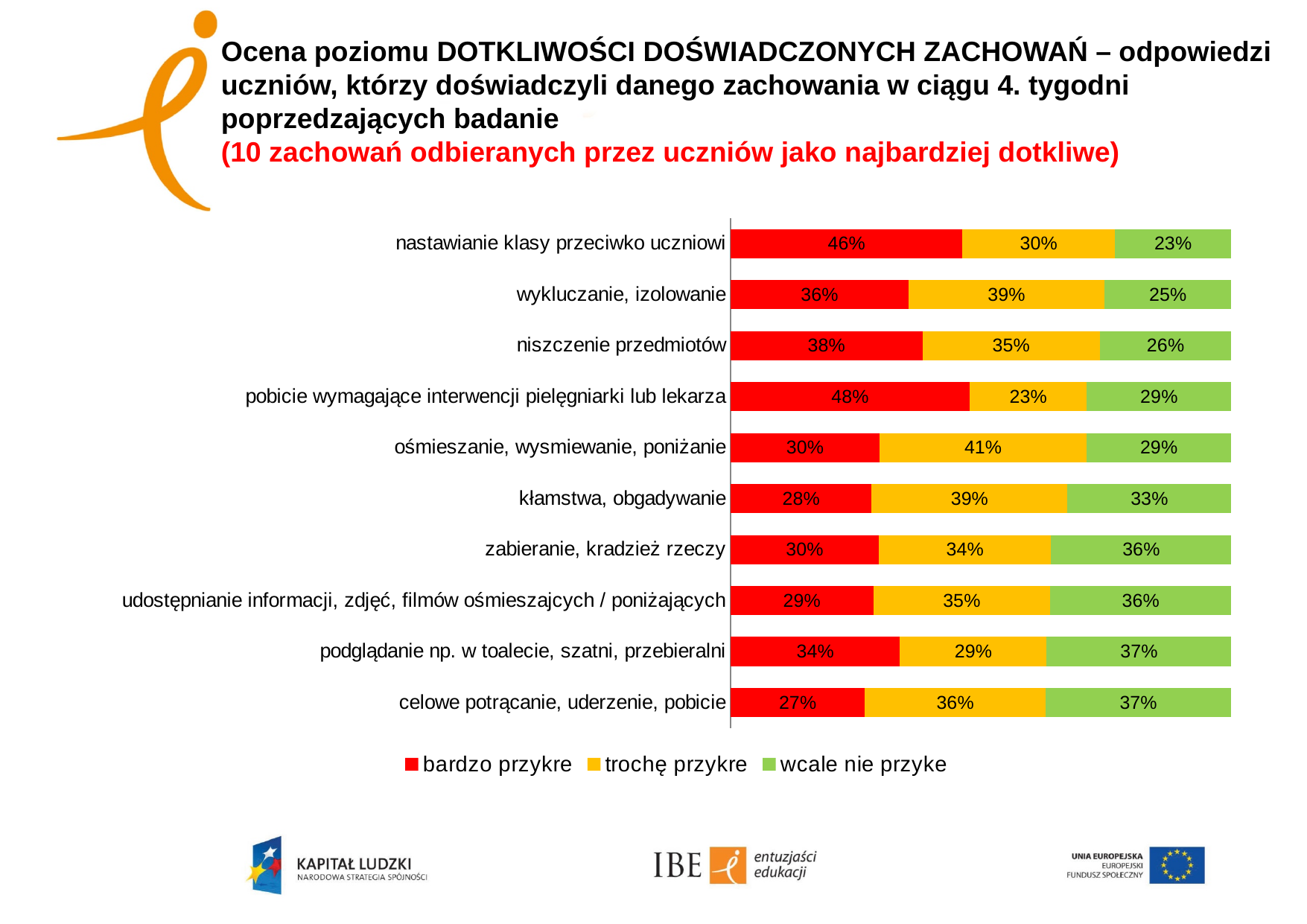
Which is larger: the "wcale nie przyke" value for "kłamstwa, obgadywanie" or for "niszczenie przedmiotów"? kłamstwa, obgadywanie What is the difference between the "bardzo przykre" values for "nastawianie klasy przeciwko uczniowi" and "wykluczanie, izolowanie"? 10 percentage points What is the total of the three segments for "zabieranie, kradzież rzeczy"? 100% How many series does the legend list? 3 What percentage of students rated "nastawianie klasy przeciwko uczniowi" as "bardzo przykre"? 46% How many behaviours (categories) are shown in the chart? 10 What kind of chart is shown on the slide? Stacked bar chart What is the "trochę przykre" value for "ośmieszanie, wysmiewanie, poniżanie"? 41% Which behaviour has the highest "bardzo przykre" share? pobicie wymagające interwencji pielęgniarki lub lekarza What is the "wcale nie przyke" value for "celowe potrącanie, uderzenie, pobicie"? 37% Which colour represents "wcale nie przyke" in the legend? Green Which behaviour has the lowest "bardzo przykre" share? celowe potrącanie, uderzenie, pobicie